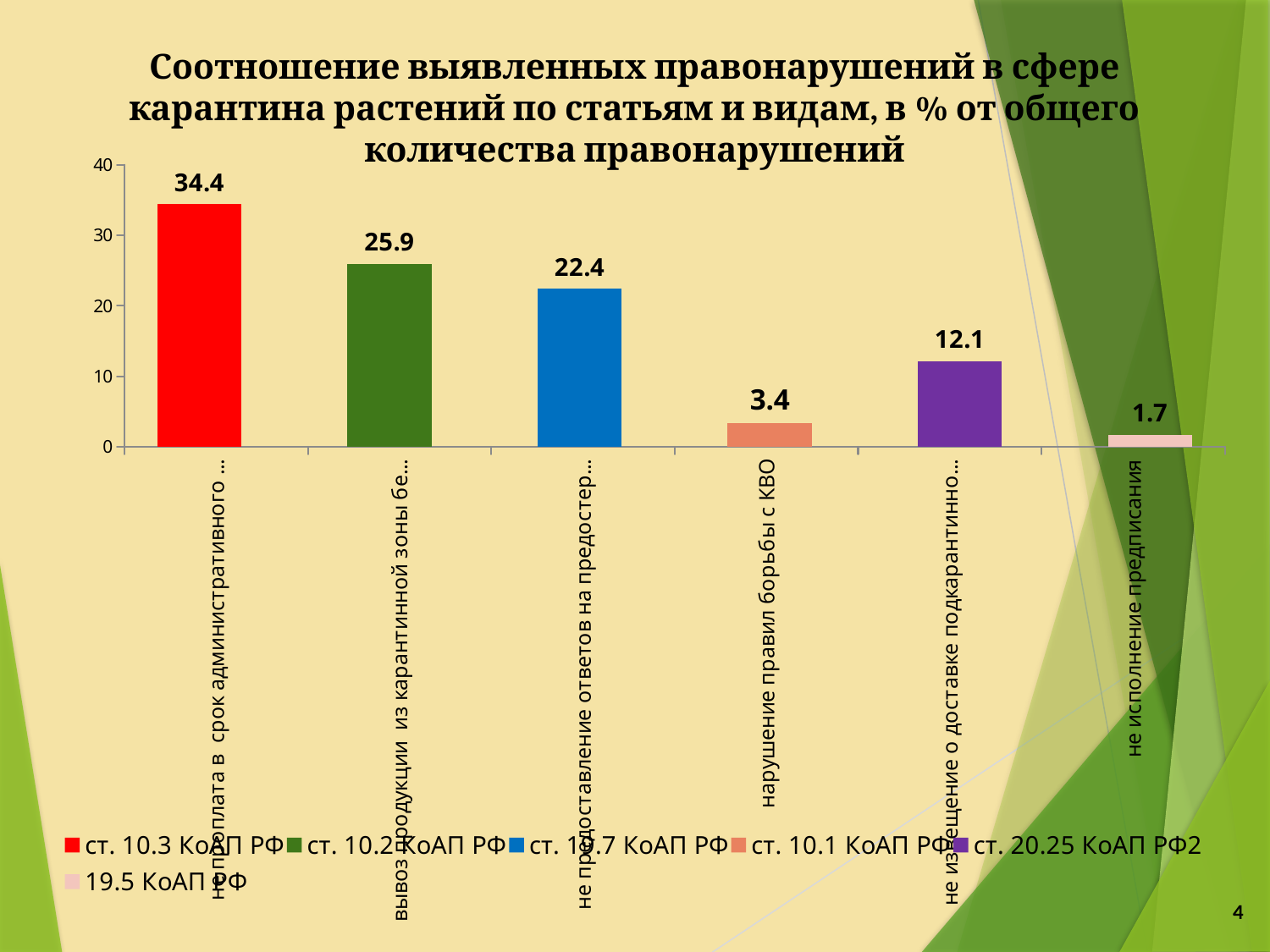
What type of chart is shown on the slide? Bar chart Which legend entry corresponds to the highest bar? ст. 10.3 КоАП РФ What is the value of the bar for "не исполнение предписания"? 1.7 What is the difference between the red bar (34.4) and the green bar (25.9)? 8.5 What is the value of the bar for "нарушение правил борьбы с КВО"? 3.4 What is the value of the blue bar (ст. 19.7 КоАП РФ)? 22.4 What is the value of the red bar (ст. 10.3 КоАП РФ)? 34.4 What is the value of the purple bar (ст. 20.25 КоАП РФ2)? 12.1 Which is larger: the value for "нарушение правил борьбы с КВО" or the value for "не исполнение предписания"? нарушение правил борьбы с КВО How many entries does the legend list? 6 Which category has the lowest value? не исполнение предписания How many bars are plotted in the chart? 6